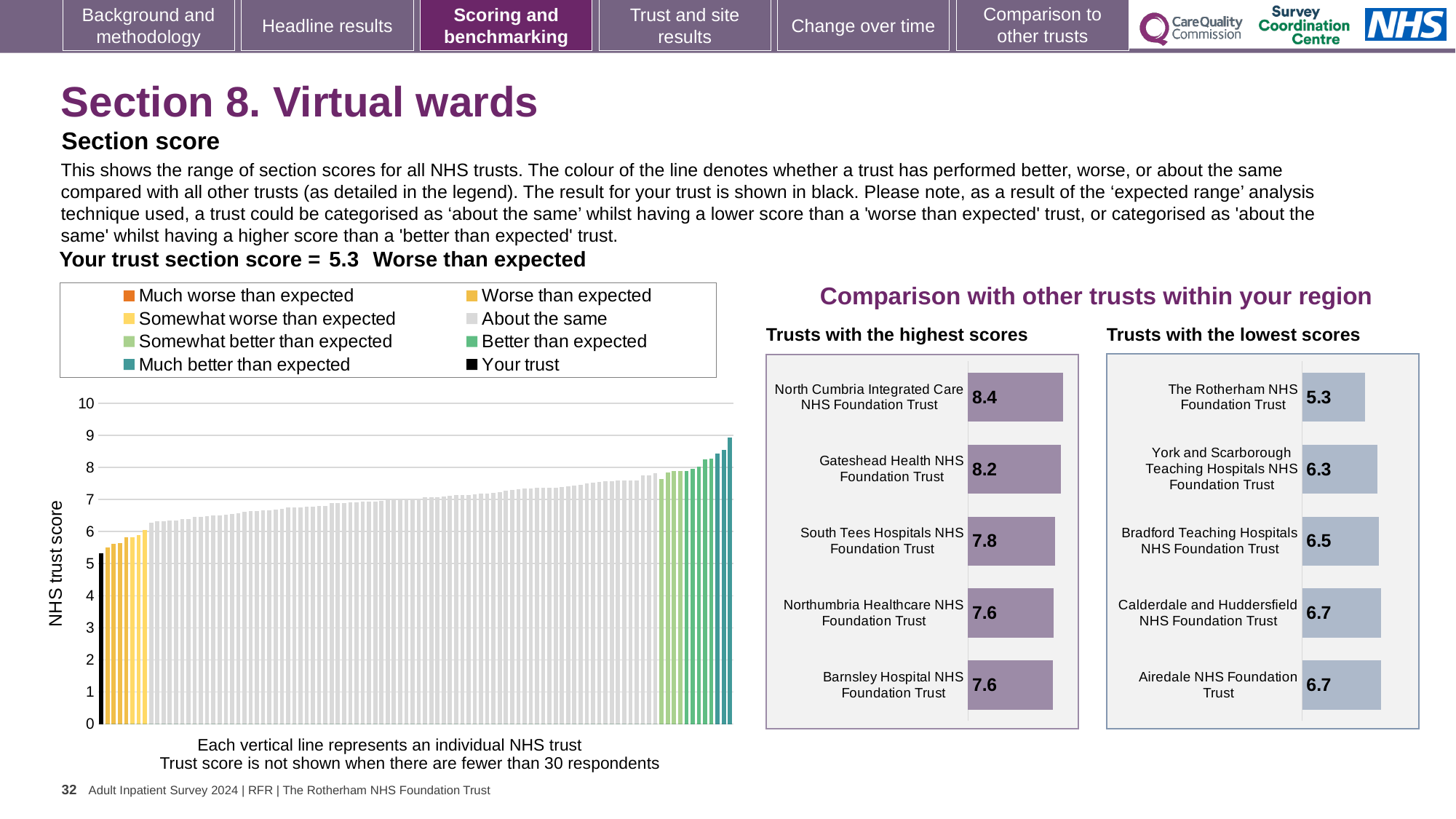
How many entries does the legend of the large chart on the left list? 8 In the 'Trusts with the lowest scores' chart, which has the higher score: Bradford Teaching Hospitals NHS Foundation Trust or York and Scarborough Teaching Hospitals NHS Foundation Trust? Bradford Teaching Hospitals NHS Foundation Trust In the 'Trusts with the lowest scores' chart, which trust has the lowest score? The Rotherham NHS Foundation Trust In the large chart on the left showing NHS trust scores, do the bar values rise or fall from left to right? rise In the 'Trusts with the highest scores' chart, what is the score for South Tees Hospitals NHS Foundation Trust? 7.8 In the 'Trusts with the highest scores' chart, which trust has the highest score? North Cumbria Integrated Care NHS Foundation Trust In the 'Trusts with the lowest scores' chart, what is the score for York and Scarborough Teaching Hospitals NHS Foundation Trust? 6.3 In the 'Trusts with the lowest scores' chart, what is the difference between the scores of Bradford Teaching Hospitals NHS Foundation Trust and The Rotherham NHS Foundation Trust? 1.2 In the 'Trusts with the highest scores' chart, what is the score for North Cumbria Integrated Care NHS Foundation Trust? 8.4 How many trusts are listed in the 'Trusts with the lowest scores' chart? 5 In the large chart on the left showing NHS trust scores, is the value of the tallest bar greater or less than 8? greater In the 'Trusts with the highest scores' chart, what is the difference between the scores of North Cumbria Integrated Care NHS Foundation Trust and South Tees Hospitals NHS Foundation Trust? 0.6